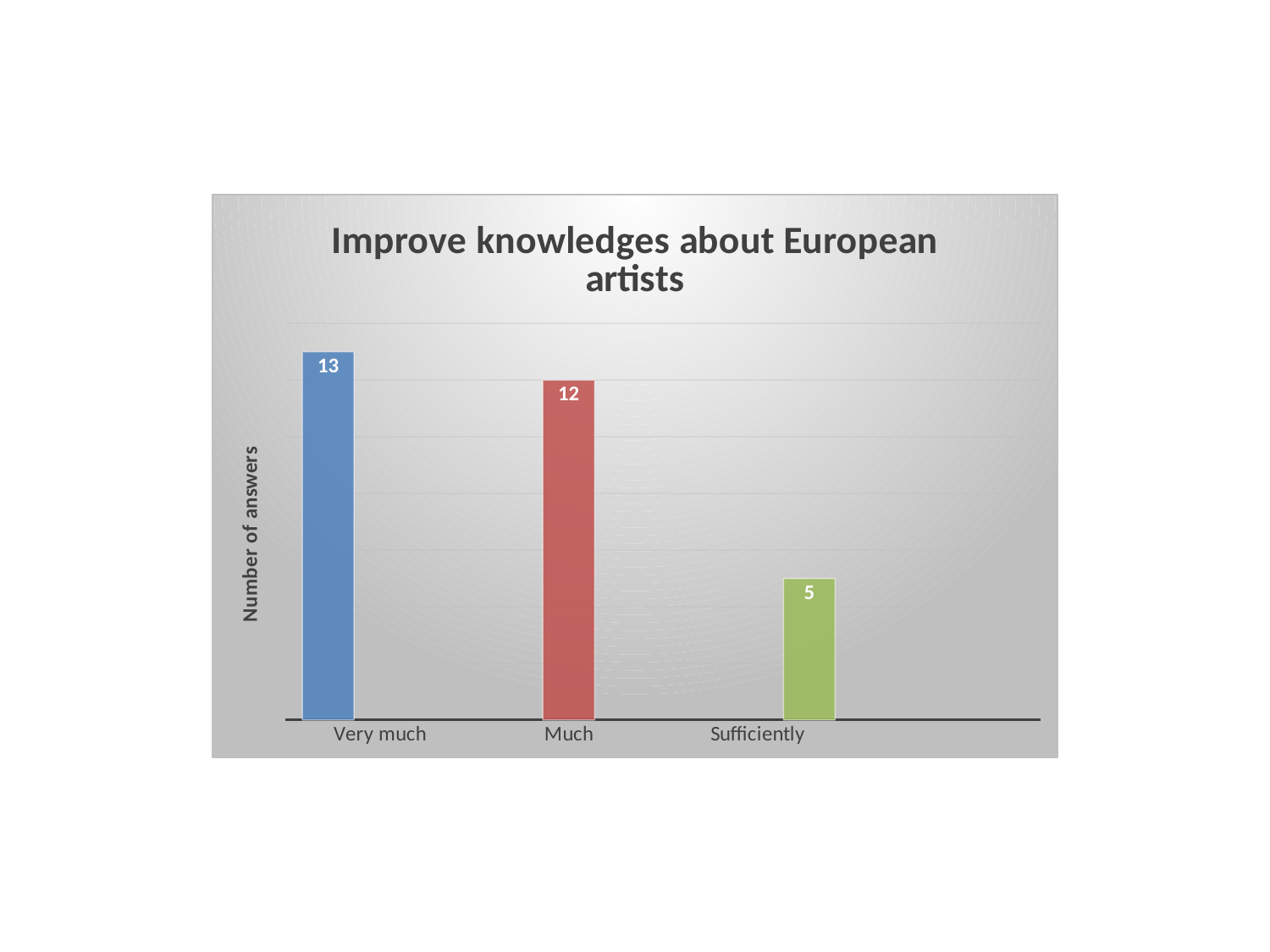
Which category has the highest number of answers? Very much What is the difference between the values for "Very much" and "Sufficiently"? 8 What is the value for "Sufficiently"? 5 Which category has the lowest number of answers? Sufficiently What is the value for "Very much"? 13 What is the title of the chart? Improve knowledges about European artists What kind of chart is shown on the slide? Bar chart What is the difference between the values for "Much" and "Sufficiently"? 7 Do the values rise or fall from left to right along the x axis? Fall What is the value for "Much"? 12 How many categories are shown on the x axis? 3 Which is larger, the value for "Much" or the value for "Sufficiently"? Much